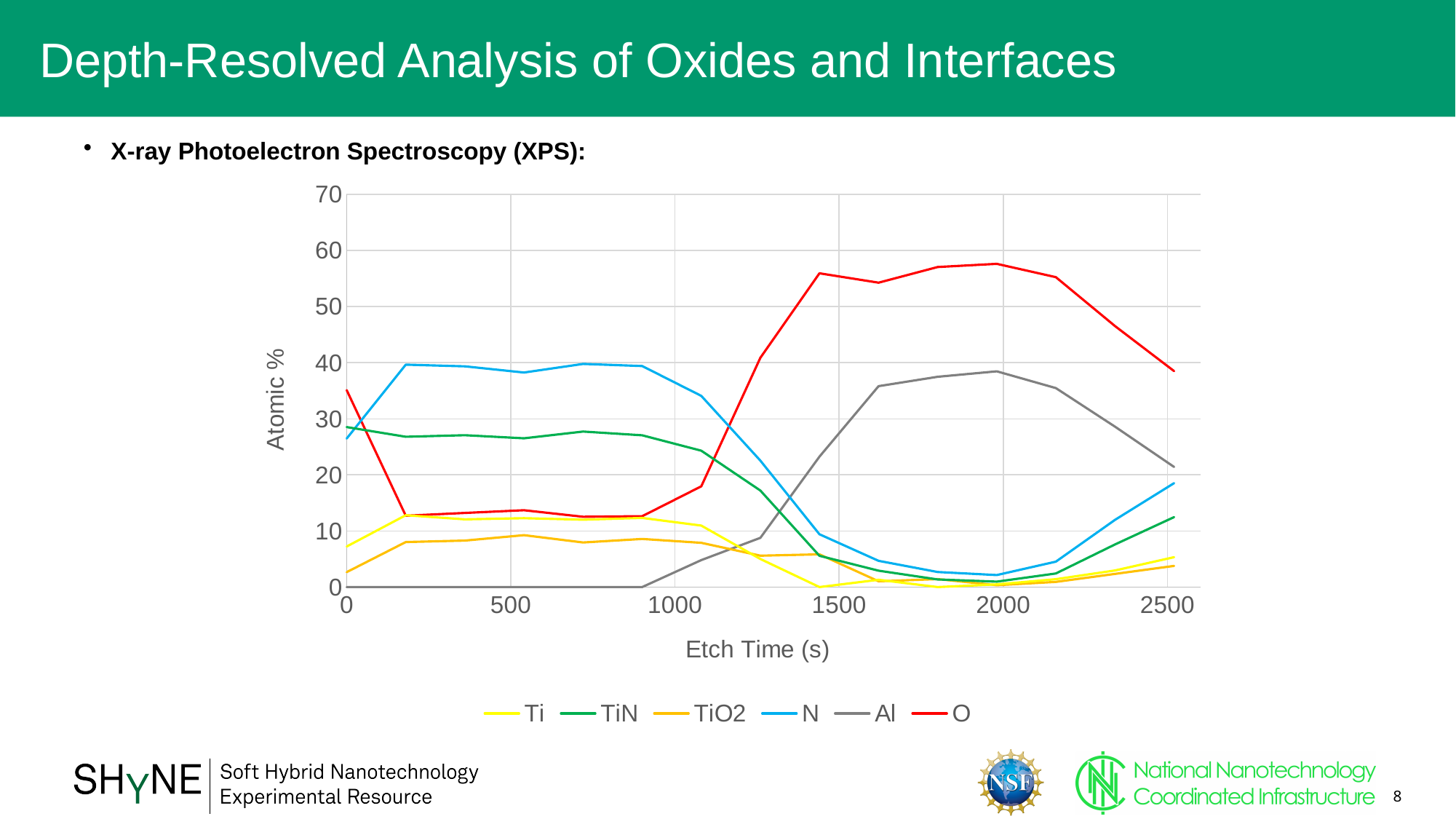
Which series are listed in the chart legend? Ti, TiN, TiO2, N, Al, O Is the value for N at an etch time of 0 s greater or less than 20? greater Which series has the highest value at an etch time of 0 s? O What is the title of the vertical axis? Atomic % Is the value for O at an etch time of 2000 s greater or less than 50? greater What kind of chart is shown on the slide? line chart Does the N series rise or fall between 1000 s and 2000 s? fall Does the Al series rise or fall between 1000 s and 2000 s? rise How many series does the legend list? 6 At an etch time of 500 s, which is larger, N or TiN? N Is the value for Al at an etch time of 500 s greater or less than 10? less Which series reaches the highest value anywhere on the chart? O